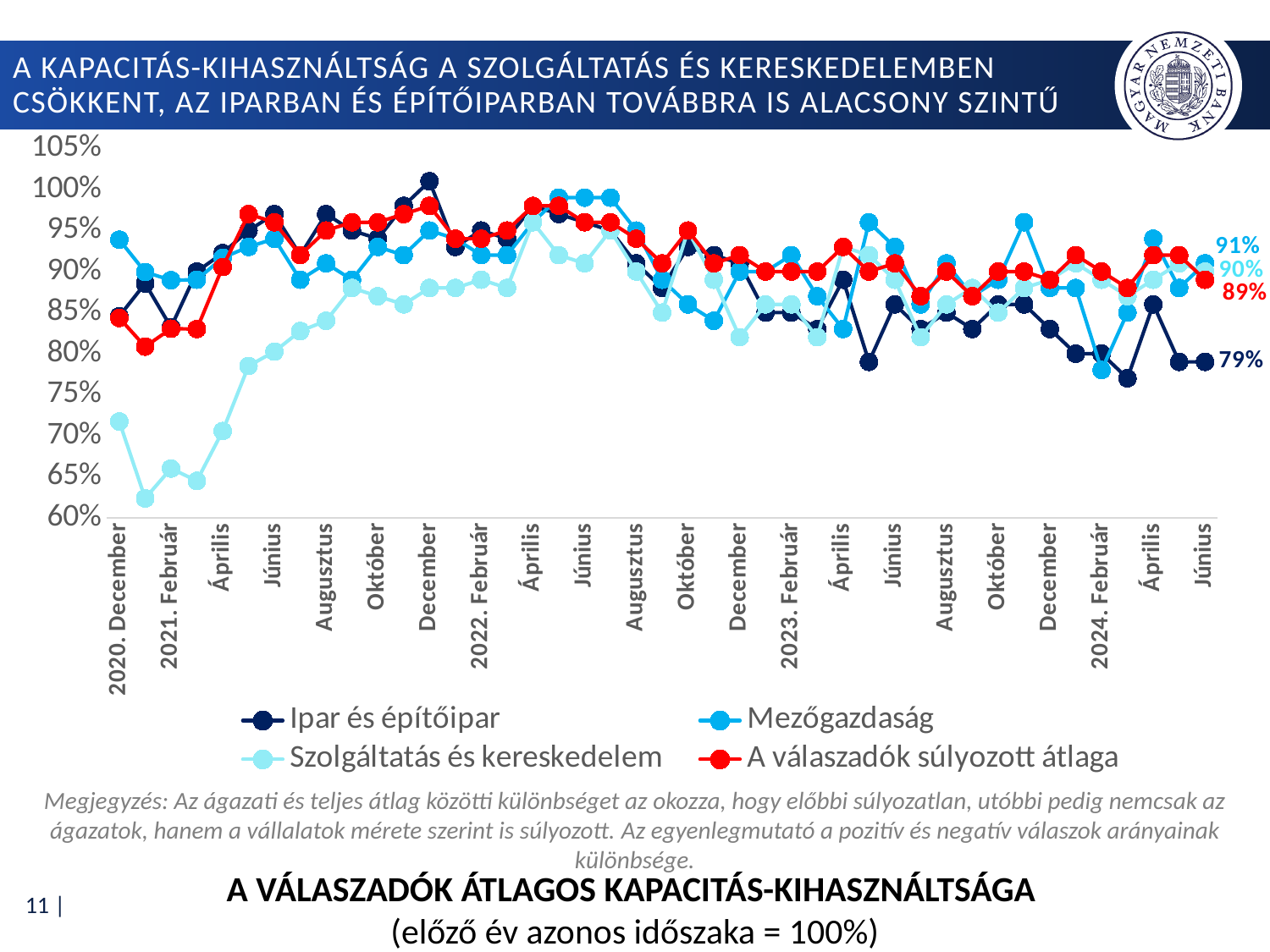
Which series is drawn in red? A válaszadók súlyozott átlaga What is the value labelled at the end of the A válaszadók súlyozott átlaga line (2024 Június)? 89% What is the difference between the final labelled values of A válaszadók súlyozott átlaga (89%) and Ipar és építőipar (79%)? 10 percentage points Which series has the lowest value at the last point (2024 Június)? Ipar és építőipar Does the Szolgáltatás és kereskedelem line rise or fall between 2020. December and 2022 Június? rise Is the value for Ipar és építőipar at 2021 December greater or less than 95%? greater What is the highest value shown on the vertical axis? 105% What is the value labelled at the end of the Ipar és építőipar line (2024 Június)? 79% At 2020. December, which is higher: Mezőgazdaság or Szolgáltatás és kereskedelem? Mezőgazdaság How many series does the legend list? 4 What kind of chart is shown on the slide? line chart Is the value for Szolgáltatás és kereskedelem at 2021. Február greater or less than 70%? less